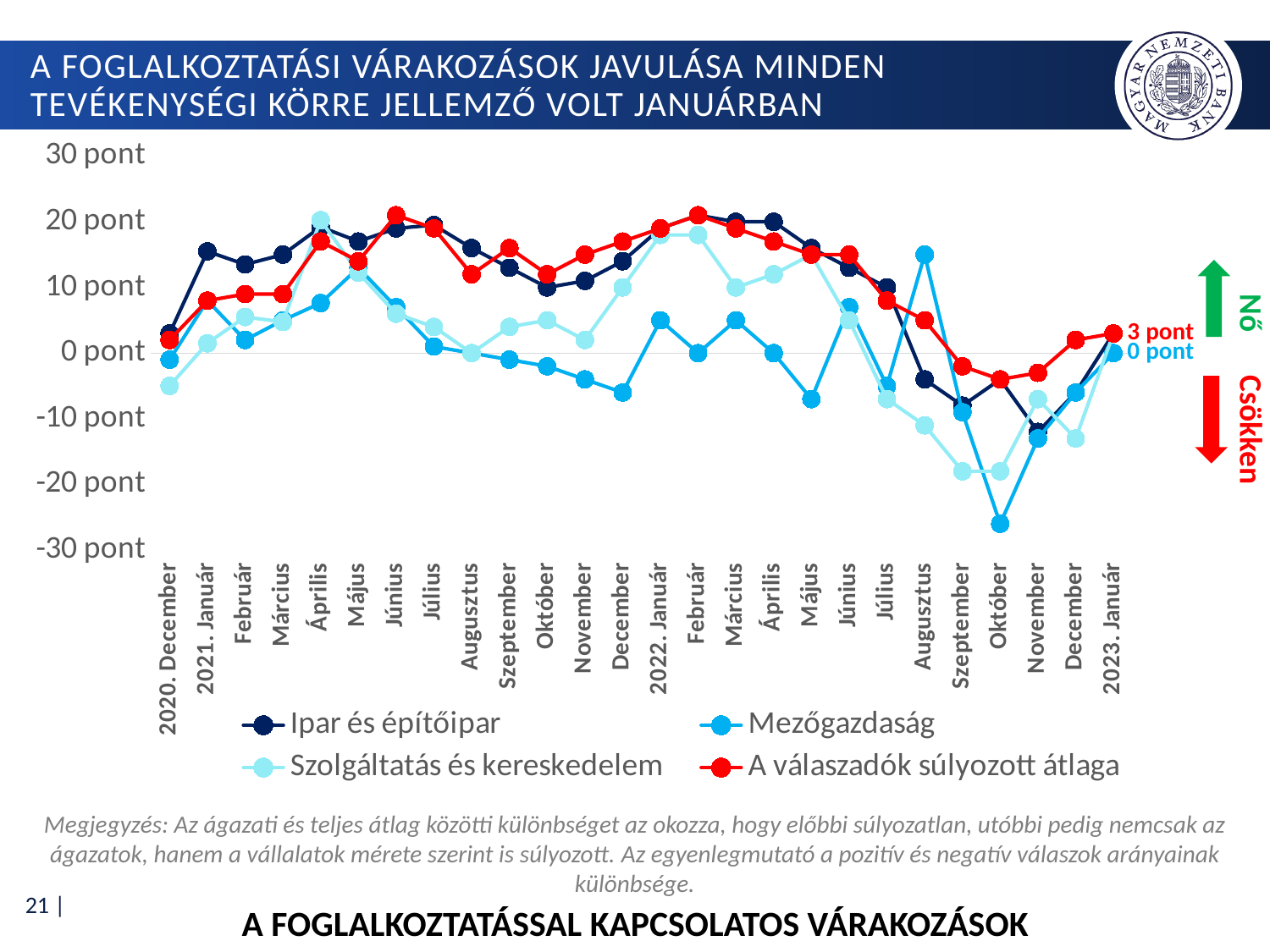
What kind of chart is shown on the slide? line chart In 2022 Október, which is larger: 'Mezőgazdaság' or 'Szolgáltatás és kereskedelem'? Szolgáltatás és kereskedelem In which month does 'Mezőgazdaság' reach its lowest value? 2022 Október Is the value for 'Ipar és építőipar' in 2021. Január greater or less than 10 pont? greater Is the value for 'Mezőgazdaság' in 2022 Október greater or less than -20 pont? less What is the value of 'Mezőgazdaság' in 2023. Január? 0 pont What is the difference between 'A válaszadók súlyozott átlaga' and 'Mezőgazdaság' in 2023. Január? 3 pont What is the value of 'A válaszadók súlyozott átlaga' in 2023. Január? 3 pont Does 'A válaszadók súlyozott átlaga' rise or fall from 2022 Október to 2023. Január? rise What colour is the line for 'A válaszadók súlyozott átlaga'? red How many months (points) are plotted along the x axis? 26 How many series does the legend list? 4